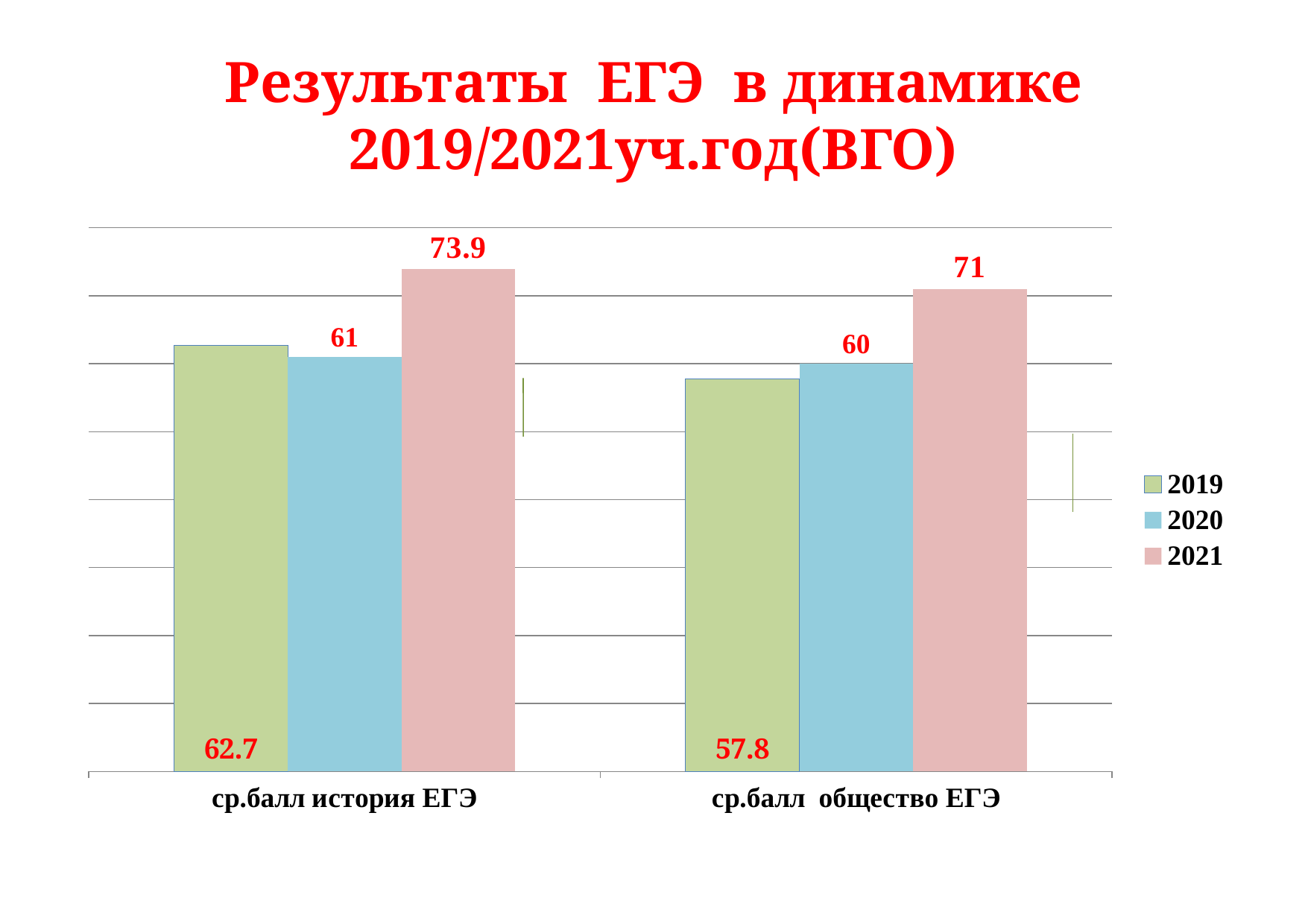
What is the 2020 value for ср.балл история ЕГЭ? 61 What is the 2021 value for ср.балл общество ЕГЭ? 71 How many series does the legend list? 3 What is the difference between the 2021 and 2019 values for ср.балл история ЕГЭ? 11.2 Which is larger: the 2021 value for ср.балл история ЕГЭ or the 2021 value for ср.балл общество ЕГЭ? ср.балл история ЕГЭ What is the 2021 value for ср.балл история ЕГЭ? 73.9 Which year has the highest value for ср.балл история ЕГЭ? 2021 How many categories are shown on the x axis? 2 What kind of chart is shown on the slide? Bar chart What is the 2019 value for ср.балл общество ЕГЭ? 57.8 What is the difference between the 2021 and 2020 values for ср.балл общество ЕГЭ? 11 Which year has the lowest value for ср.балл общество ЕГЭ? 2019